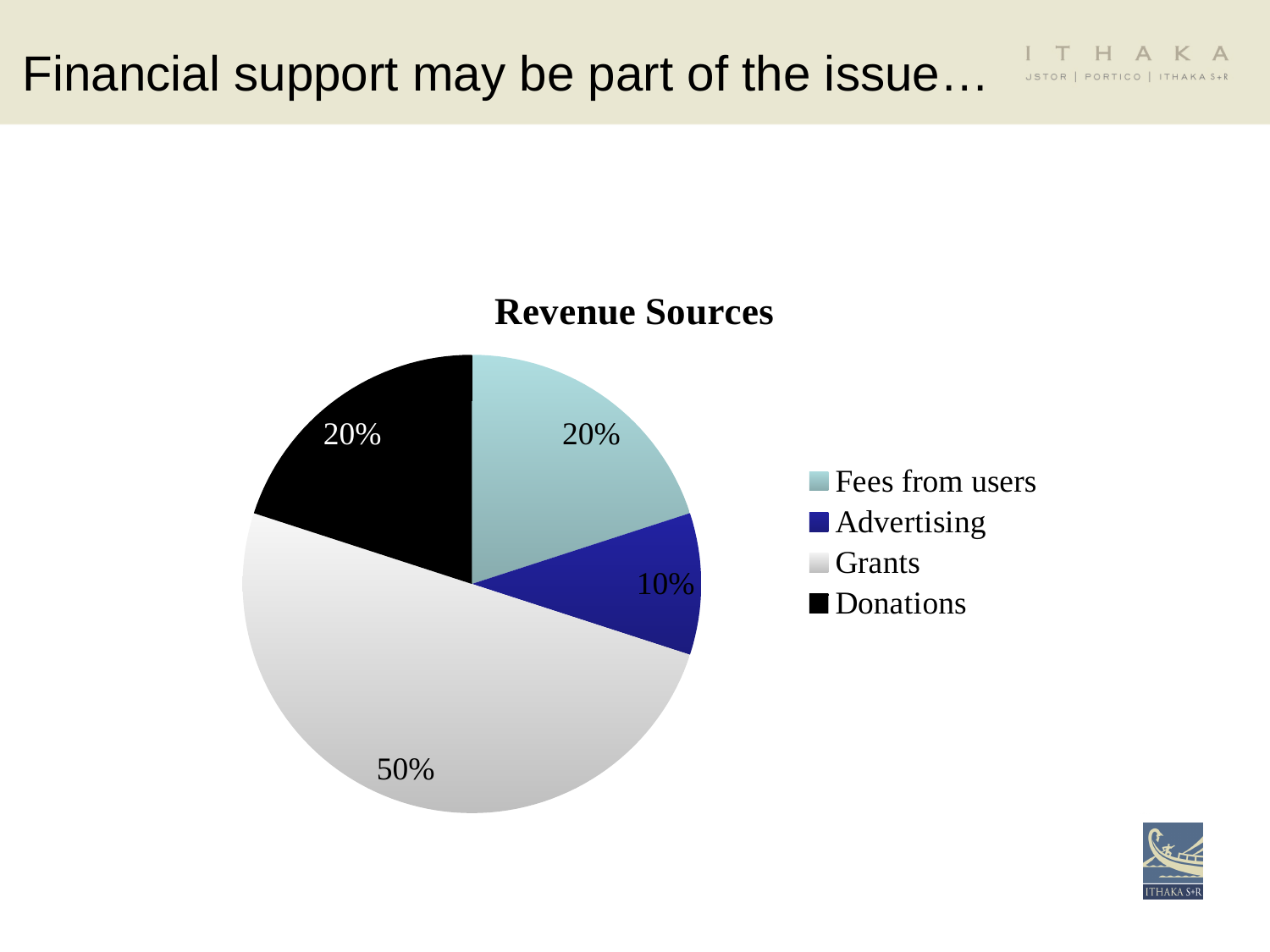
Which colour represents Donations in the chart? black What is the difference between the Grants share and the Advertising share? 40% What share of revenue comes from Advertising? 10% How many revenue sources are shown in the pie chart? 4 What share of revenue comes from Fees from users? 20% Which revenue source has the largest share? Grants What share of revenue comes from Donations? 20% Which is larger, the share for Grants or the share for Donations? Grants Which revenue source has the smallest share? Advertising What type of chart is shown on the slide? pie chart What is the title of the chart? Revenue Sources What share of revenue comes from Grants? 50%